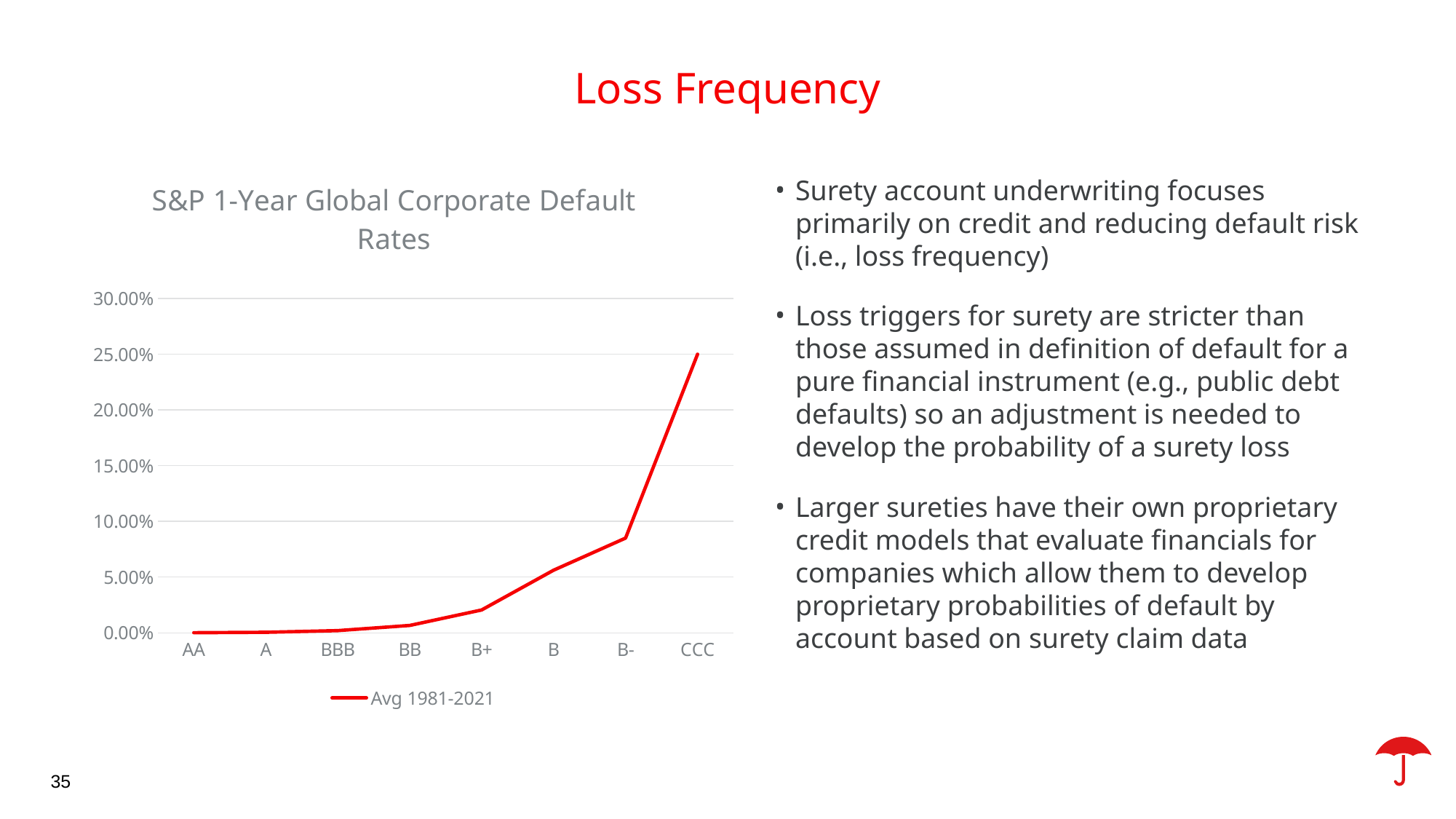
What is the name of the series shown in the chart legend? Avg 1981-2021 Which rating category has the lowest default rate in the chart? AA How many series does the chart legend list? 1 Do the default rates rise or fall moving from AA to CCC along the x axis? rise What is the title of the chart? S&P 1-Year Global Corporate Default Rates Is the default rate for B+ greater or less than 5.00%? less How many rating categories are shown on the x axis of the chart? 8 What kind of chart is shown on the slide? line chart Which has a higher default rate, B- or CCC? CCC Which rating category has the highest default rate in the chart? CCC Is the default rate for CCC greater or less than 20.00%? greater Is the default rate for B- greater or less than 10.00%? less